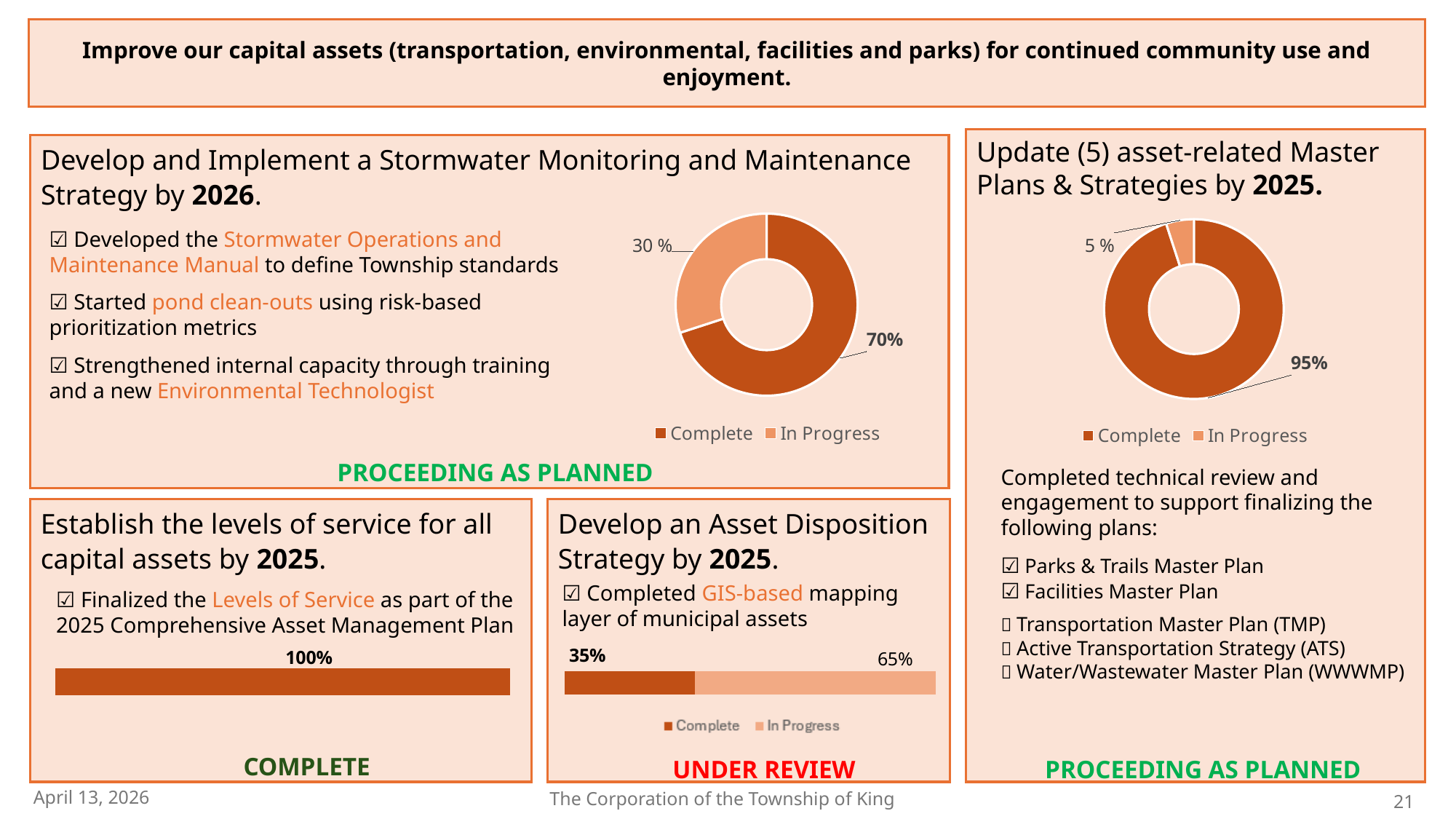
In the bar chart for Develop an Asset Disposition Strategy, what value is shown for In Progress? 65% In the donut chart for the Stormwater Monitoring and Maintenance Strategy, which slice is larger, Complete or In Progress? Complete In the bar chart for Develop an Asset Disposition Strategy, what is the total of the stacked bar? 100% In the donut chart for the Stormwater Monitoring and Maintenance Strategy, what is the difference between the Complete and In Progress shares? 40% In the donut chart for Update (5) asset-related Master Plans & Strategies, which slice is smallest? In Progress In the donut chart for Update (5) asset-related Master Plans & Strategies, what share is labelled Complete? 95% In the bar chart for Establish the levels of service for all capital assets, what value is labelled on the bar? 100% In the donut chart for Update (5) asset-related Master Plans & Strategies, what share is labelled In Progress? 5 % In the donut chart for the Stormwater Monitoring and Maintenance Strategy, what share is labelled Complete? 70% In the donut chart for the Stormwater Monitoring and Maintenance Strategy, what share is labelled In Progress? 30 % How many series does the legend list for the Stormwater Monitoring and Maintenance Strategy donut chart? 2 In the bar chart for Develop an Asset Disposition Strategy, what value is shown for Complete? 35%